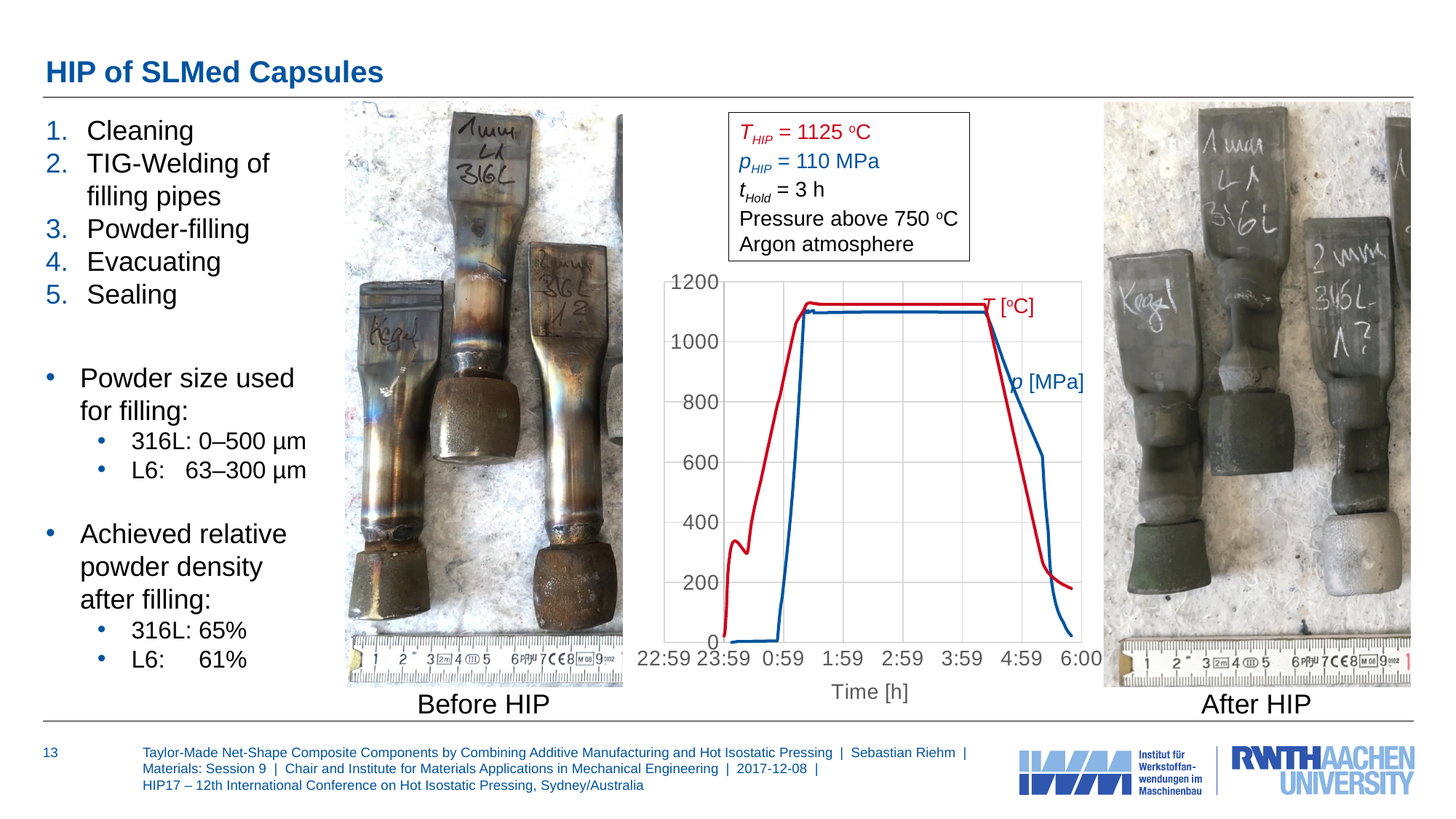
Between 23:59 and 0:59, does the T [°C] curve rise or fall? rise How many tick labels are shown on the x axis of the chart? 8 What is the highest tick value shown on the y axis of the chart? 1200 At 22:59, is the value of the p [MPa] curve greater or less than 200? less At 4:59, is the value of the p [MPa] curve greater or less than 400? greater After 3:59, does the T [°C] curve rise or fall? fall What kind of chart is shown in the middle of the slide? line chart Is the plateau value of the T [°C] curve greater or less than 1000? greater What is the label of the x axis of the chart? Time [h] At 0:59, which curve has the higher value, T [°C] or p [MPa]? T [°C] How many series are plotted in the chart? 2 Which series is drawn in red in the chart? T [°C]